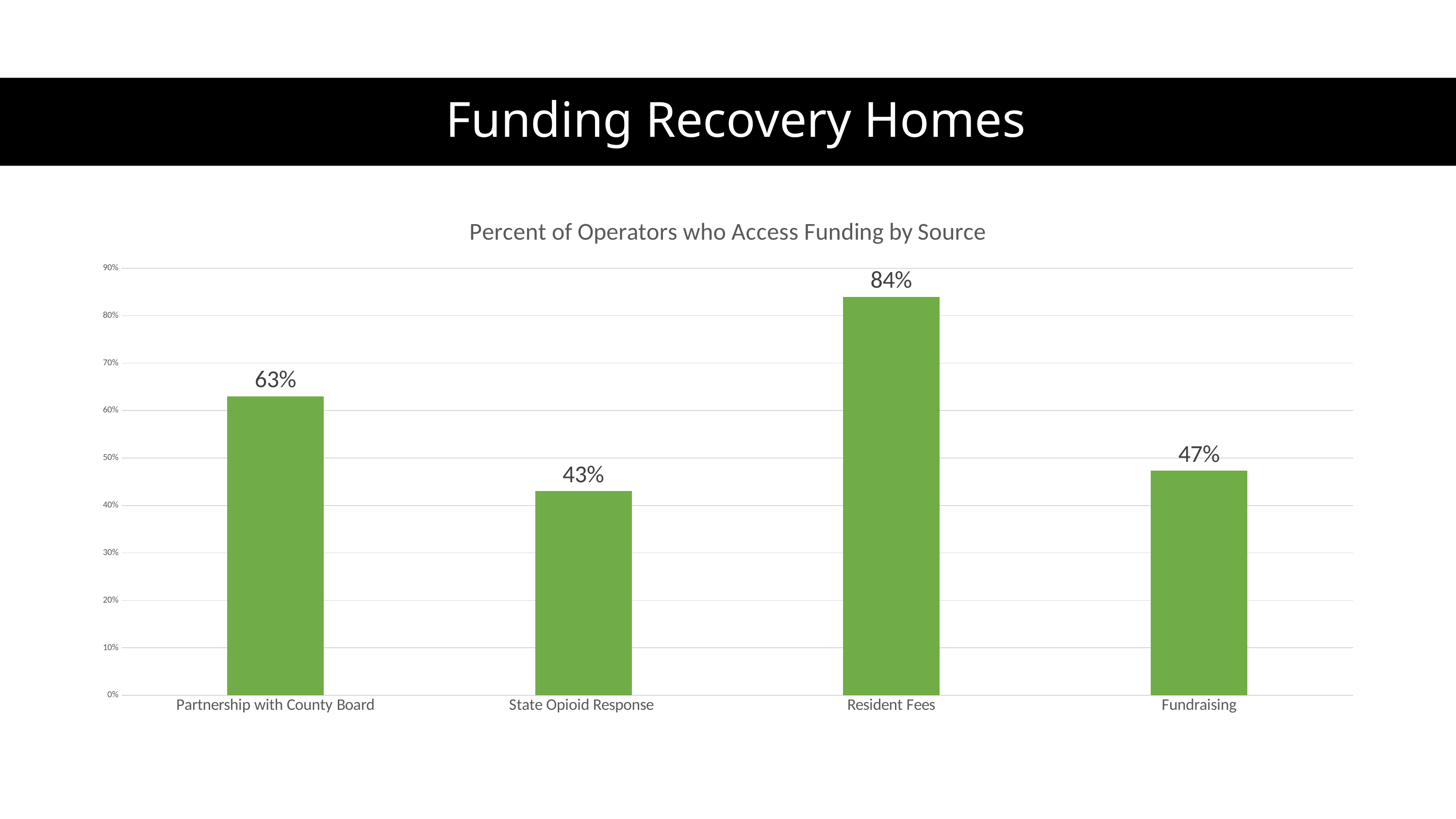
How many funding sources are shown in the chart? 4 Which is larger, the value for Partnership with County Board or the value for Fundraising? Partnership with County Board What percent of operators access funding through Resident Fees? 84% What is the difference between the values for Fundraising and State Opioid Response? 4% What is the value for Fundraising? 47% What is the difference between the values for Resident Fees and Partnership with County Board? 21% What kind of chart is shown on the slide? Bar chart Which funding source has the highest percent of operators accessing it? Resident Fees What is the value for Partnership with County Board? 63% What is the value for State Opioid Response? 43% Which funding source has the lowest percent of operators accessing it? State Opioid Response Is the value for Resident Fees greater or less than 80%? greater